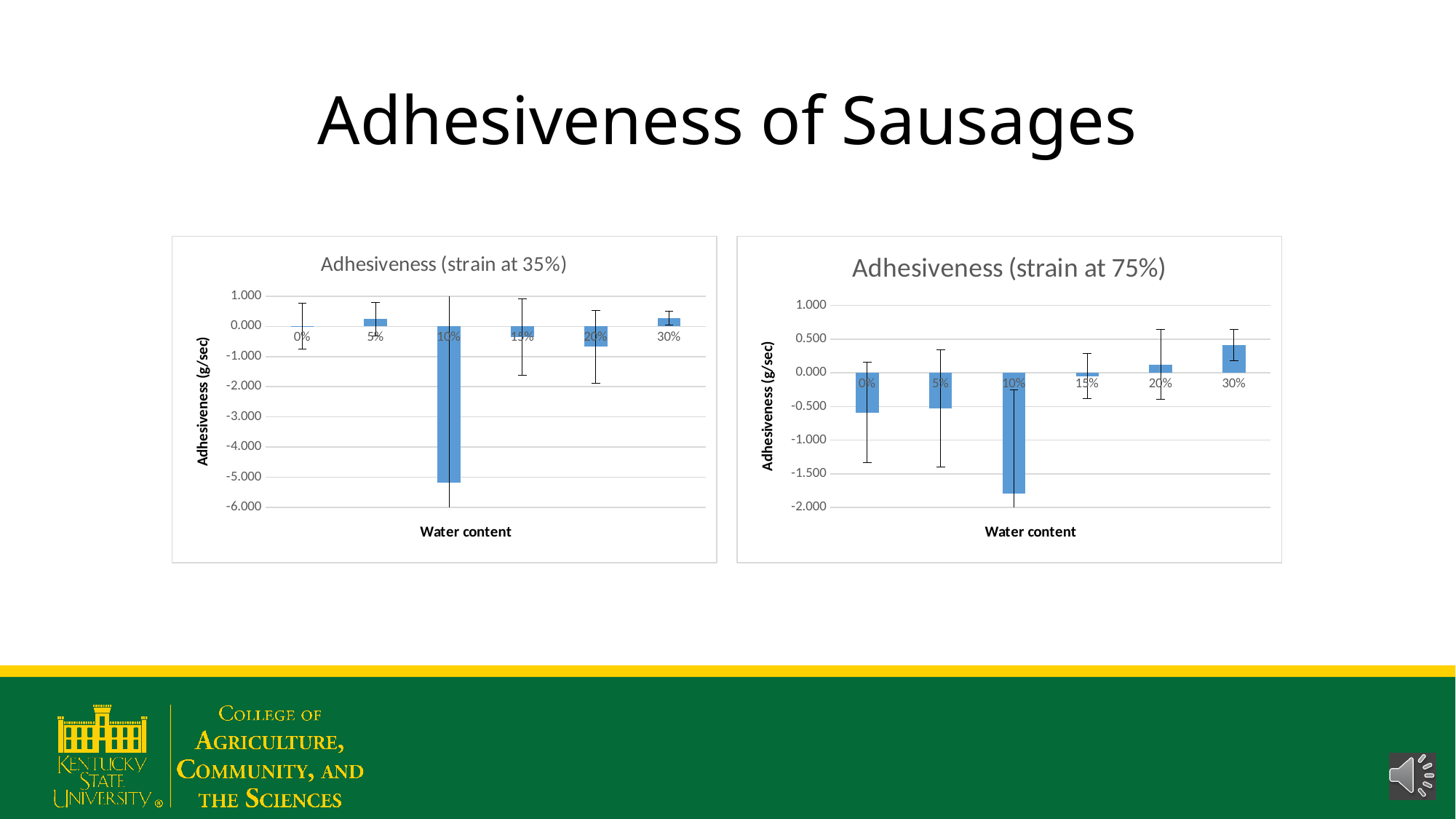
In the left chart (strain at 35%), which water content has the lowest adhesiveness? 10% In the left chart (strain at 35%), which is larger, the value for 5% or the value for 20% water content? 5% What is the x-axis label of the left chart titled "Adhesiveness (strain at 35%)"? Water content In the right chart (strain at 75%), is the value for 10% water content greater or less than -1.500? less In the right chart (strain at 75%), is the value for 30% water content greater or less than 0.500? less In the right chart (strain at 75%), which is larger, the value for 0% or the value for 10% water content? 0% In the left chart (strain at 35%), how many water content categories are shown on the x axis? 6 In the right chart (strain at 75%), which water content has the lowest adhesiveness? 10% In the right chart (strain at 75%), which water content has the highest adhesiveness? 30% What type of chart is the left chart titled "Adhesiveness (strain at 35%)"? Bar chart In the left chart (strain at 35%), is the value for 10% water content greater or less than -4.000? less What is the y-axis label of the right chart titled "Adhesiveness (strain at 75%)"? Adhesiveness (g/sec)